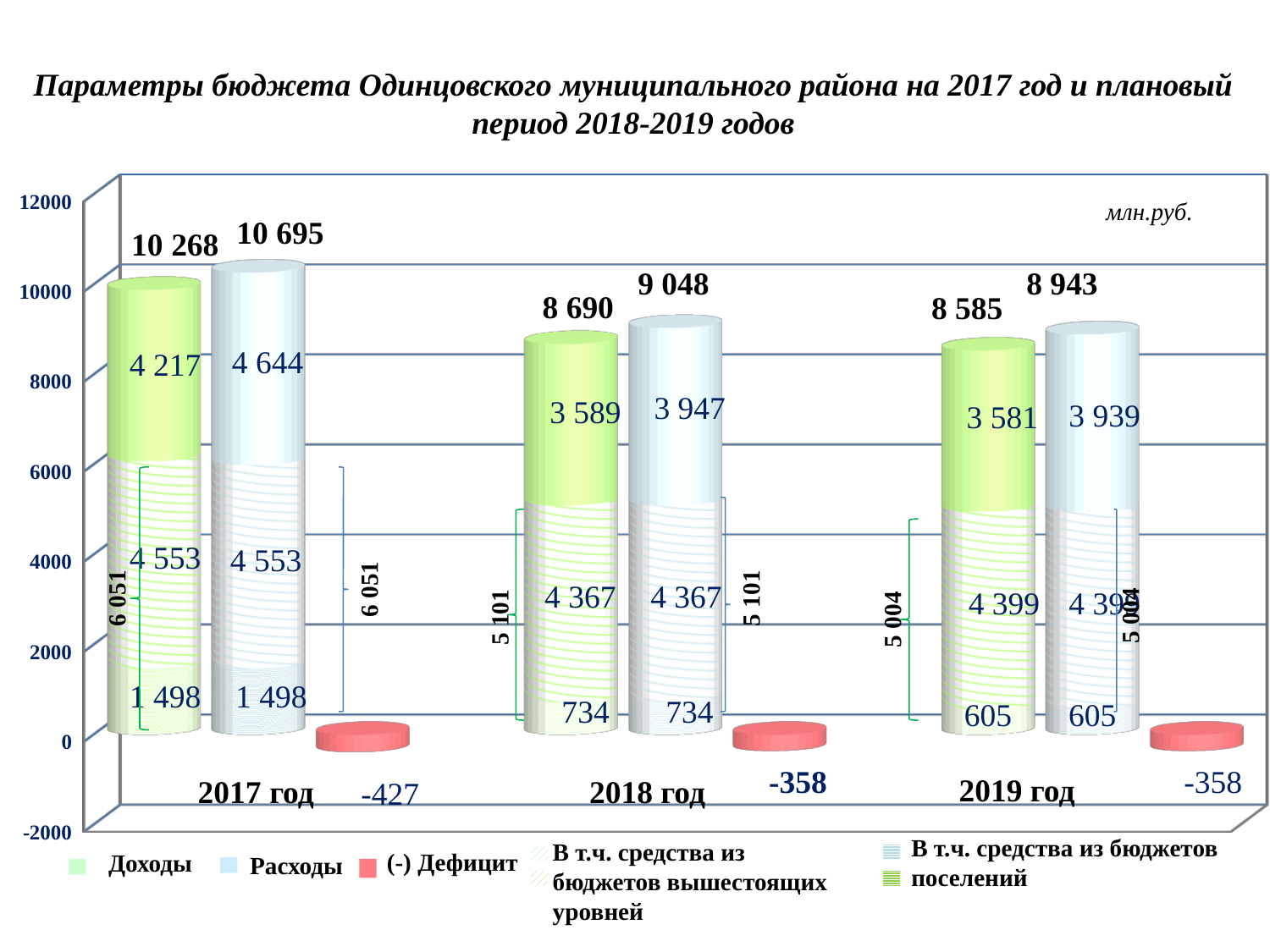
In which year is the total Расходы bar the highest? 2017 год What kind of chart is shown on the slide? Stacked bar chart What is the total value of Расходы for 2019 год? 8 943 What is the total value of Доходы for 2017 год? 10 268 In which year is the total Доходы bar the lowest? 2019 год What unit of measurement is indicated on the chart? млн.руб. How many entries does the legend list? 5 What is the value of (-) Дефицит for 2017 год? -427 What is the difference between total Расходы and total Доходы in 2018 год? 358 Do the total Доходы values rise or fall from 2017 год to 2019 год? Fall Which is larger in 2017 год: total Доходы or total Расходы? Расходы How many years (categories) are shown on the x axis? 3